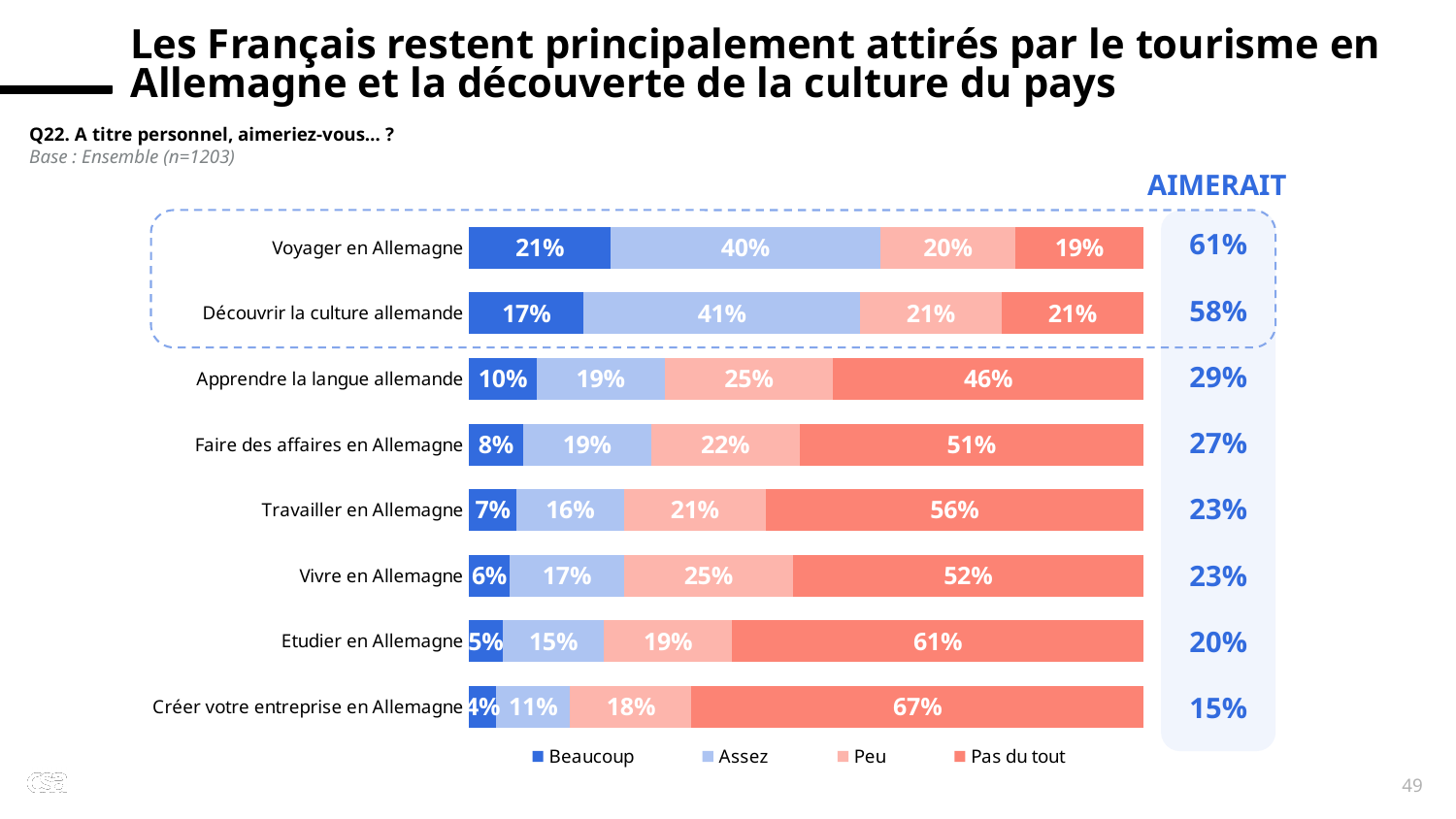
Which category has the lowest 'Beaucoup' value? Créer votre entreprise en Allemagne Which category has the highest 'Pas du tout' value? Créer votre entreprise en Allemagne How many series does the legend list? 4 What is the 'Pas du tout' value for 'Créer votre entreprise en Allemagne'? 67% What is the 'Assez' value for 'Découvrir la culture allemande'? 41% What is the combined 'Beaucoup' plus 'Assez' total (AIMERAIT) shown for 'Apprendre la langue allemande'? 29% Which legend entry is shown in the darkest blue colour? Beaucoup How many categories (activities) are plotted in the chart? 8 What is the 'Beaucoup' value for 'Voyager en Allemagne'? 21% What kind of chart is shown on the slide? Stacked bar chart Which is larger: the 'Peu' value for 'Apprendre la langue allemande' or the 'Peu' value for 'Faire des affaires en Allemagne'? Apprendre la langue allemande What is the difference between the 'Pas du tout' values for 'Etudier en Allemagne' and 'Travailler en Allemagne'? 5%